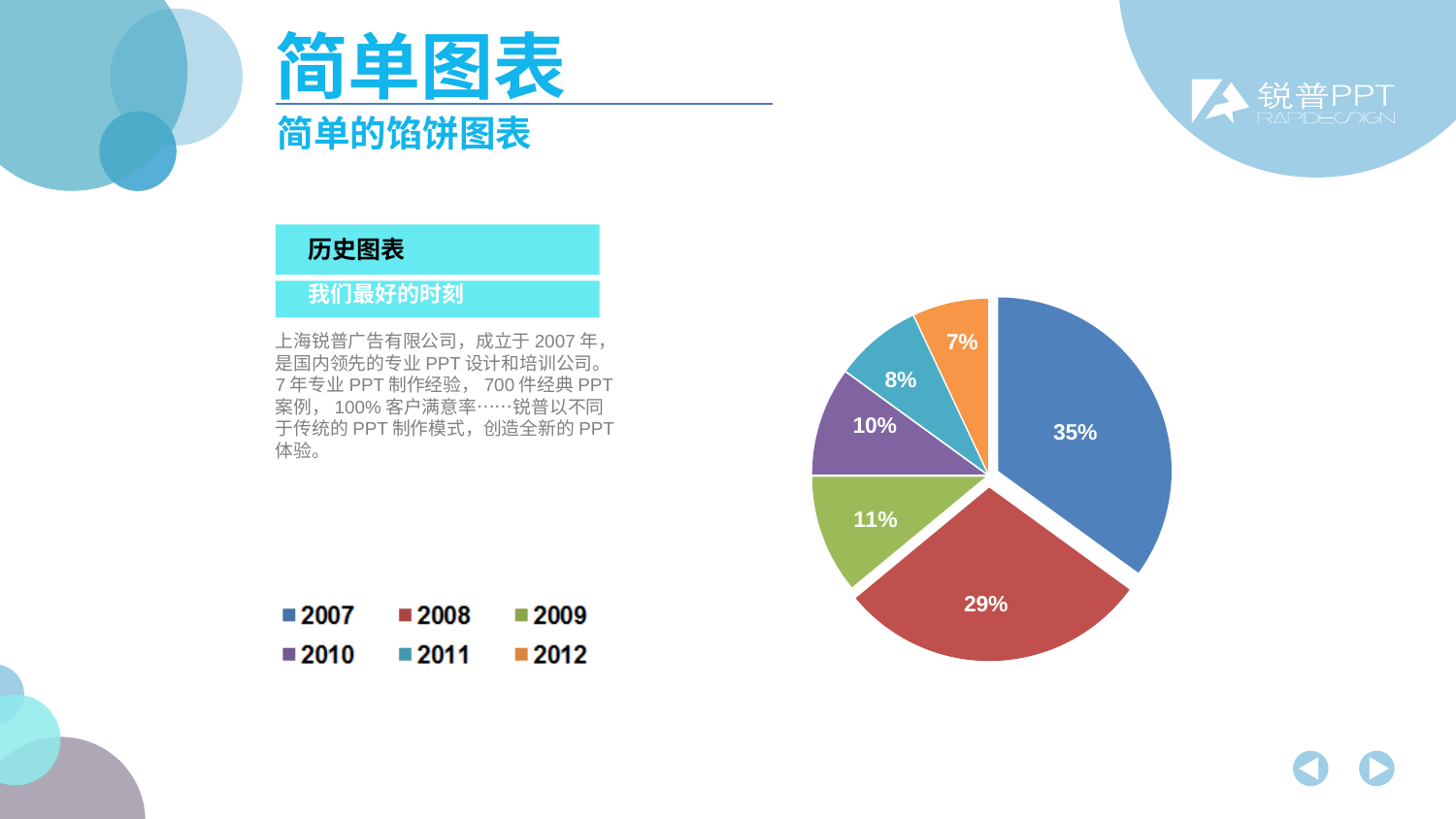
What colour is the slice for 2011? teal Which year has the largest slice of the pie? 2007 What is the difference between the shares for 2007 and 2008? 6% What share of the pie does 2007 have? 35% How many slices does the pie chart have? 6 How many entries does the legend list? 6 What share of the pie does 2012 have? 7% Which year has the smallest slice of the pie? 2012 What share of the pie does 2008 have? 29% What kind of chart is shown on the slide? pie chart What share of the pie does 2010 have? 10% Which is larger, the share for 2009 or the share for 2011? 2009